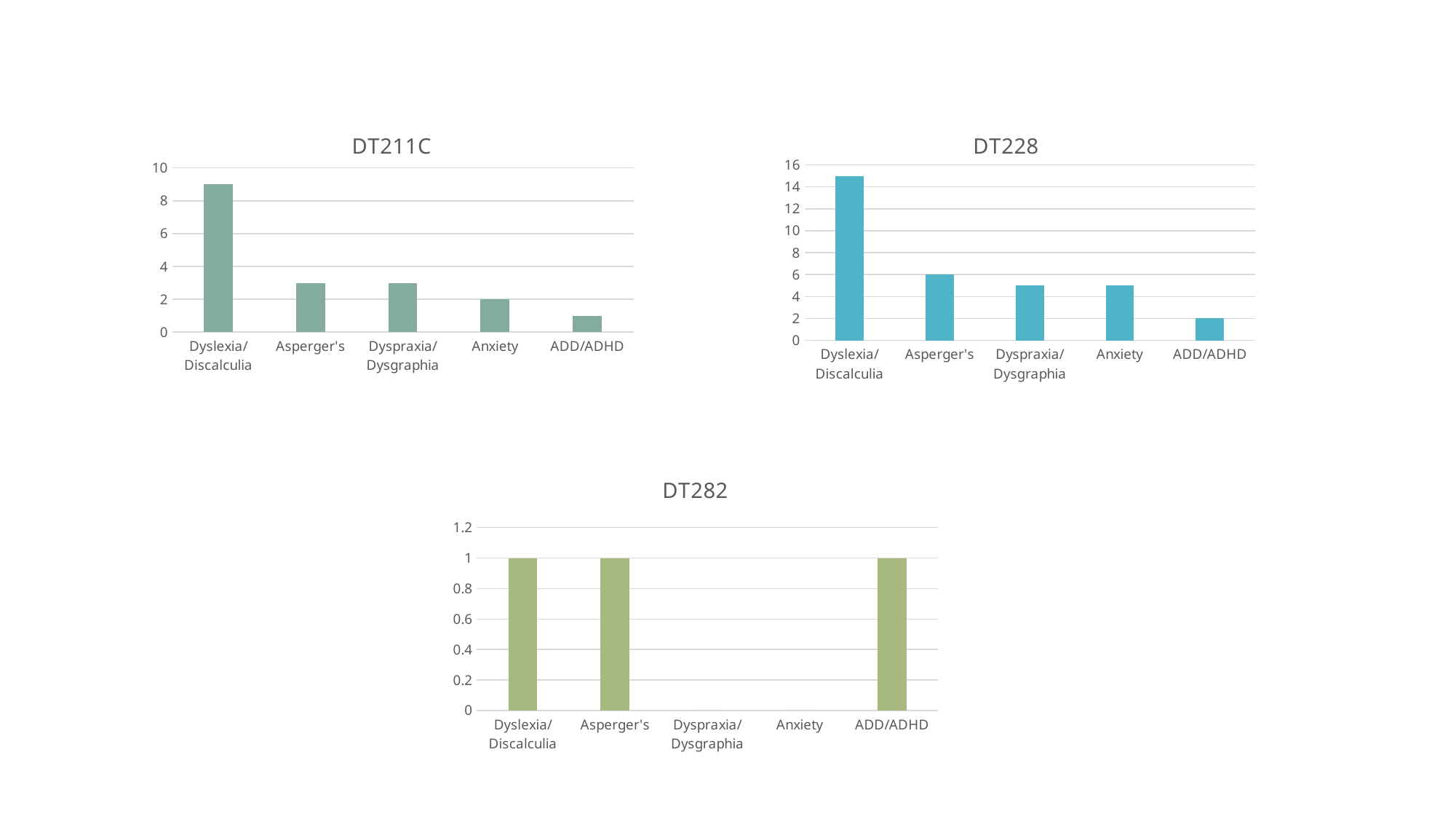
In the DT211C chart, which category has the lowest value? ADD/ADHD In the DT228 chart, which category has the highest value? Dyslexia/Discalculia In the DT228 chart, what is the difference between the values for Asperger's and ADD/ADHD? 4 In the DT211C chart, what is the value for Anxiety? 2 How many categories are shown on the x axis of the DT282 chart? 5 In the DT282 chart, what is the value for Asperger's? 1 What type of chart is the DT282 chart? Bar chart In the DT228 chart, is the value for Dyslexia/Discalculia greater or less than 14? greater In the DT228 chart, what is the value for Asperger's? 6 In the DT211C chart, which category has the highest value? Dyslexia/Discalculia In the DT228 chart, what is the value for ADD/ADHD? 2 In the DT211C chart, is the value for Dyslexia/Discalculia greater or less than 8? greater